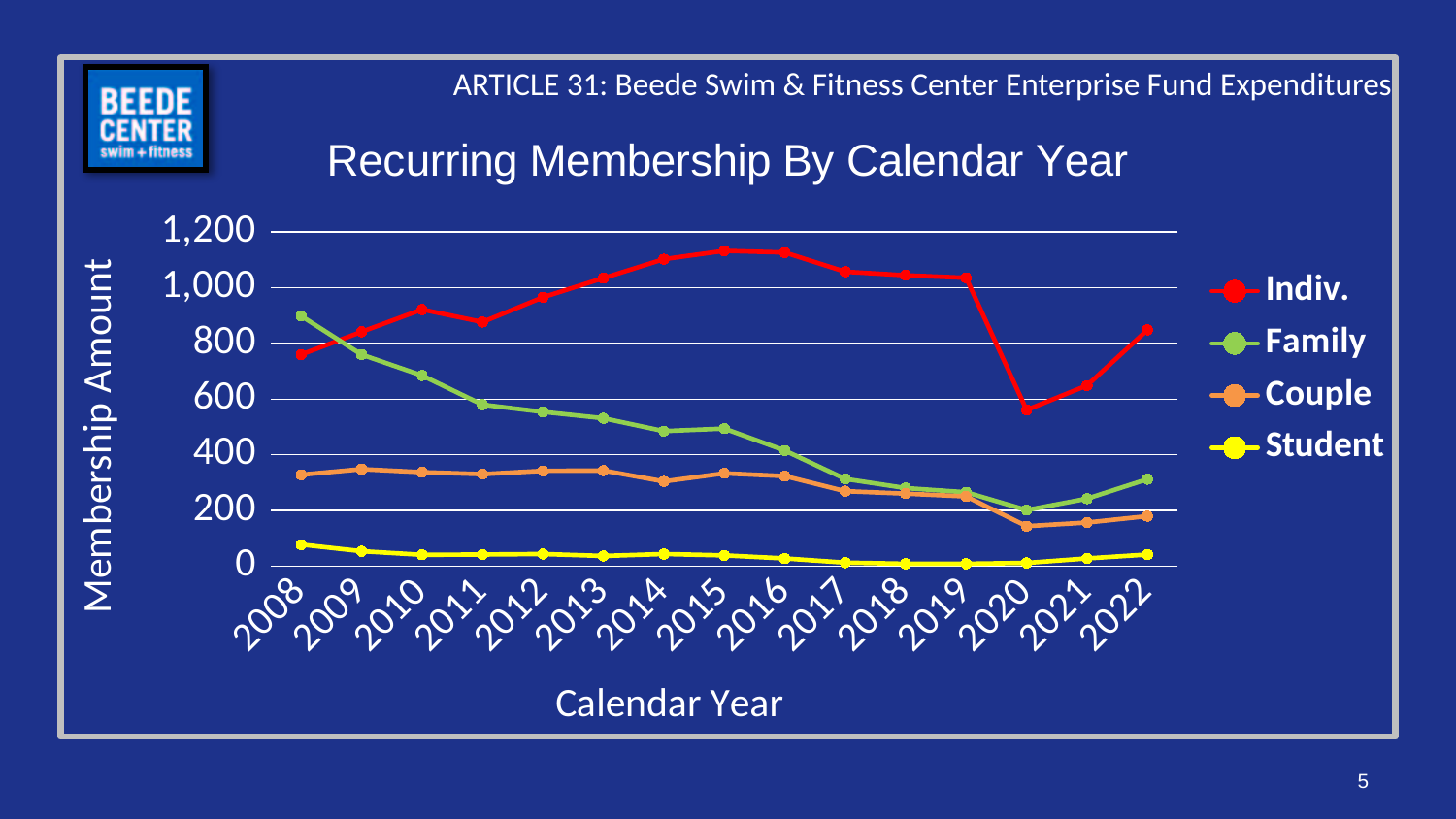
What is the title of the x axis? Calendar Year Is the Indiv. value for 2020 greater or less than 600? less In which year is the Family membership at its highest? 2008 In 2022, which is larger: the Indiv. membership or the Family membership? Indiv. Is the Family value for 2008 greater or less than 800? greater What kind of chart is shown on the slide? line chart How many series does the legend list? 4 In 2008, which is larger: the Family membership or the Indiv. membership? Family How many calendar years are plotted along the x axis? 15 Does the Family membership rise or fall from 2008 to 2020? fall In which year is the Indiv. membership at its lowest? 2020 Is the Couple value for 2020 greater or less than 200? less